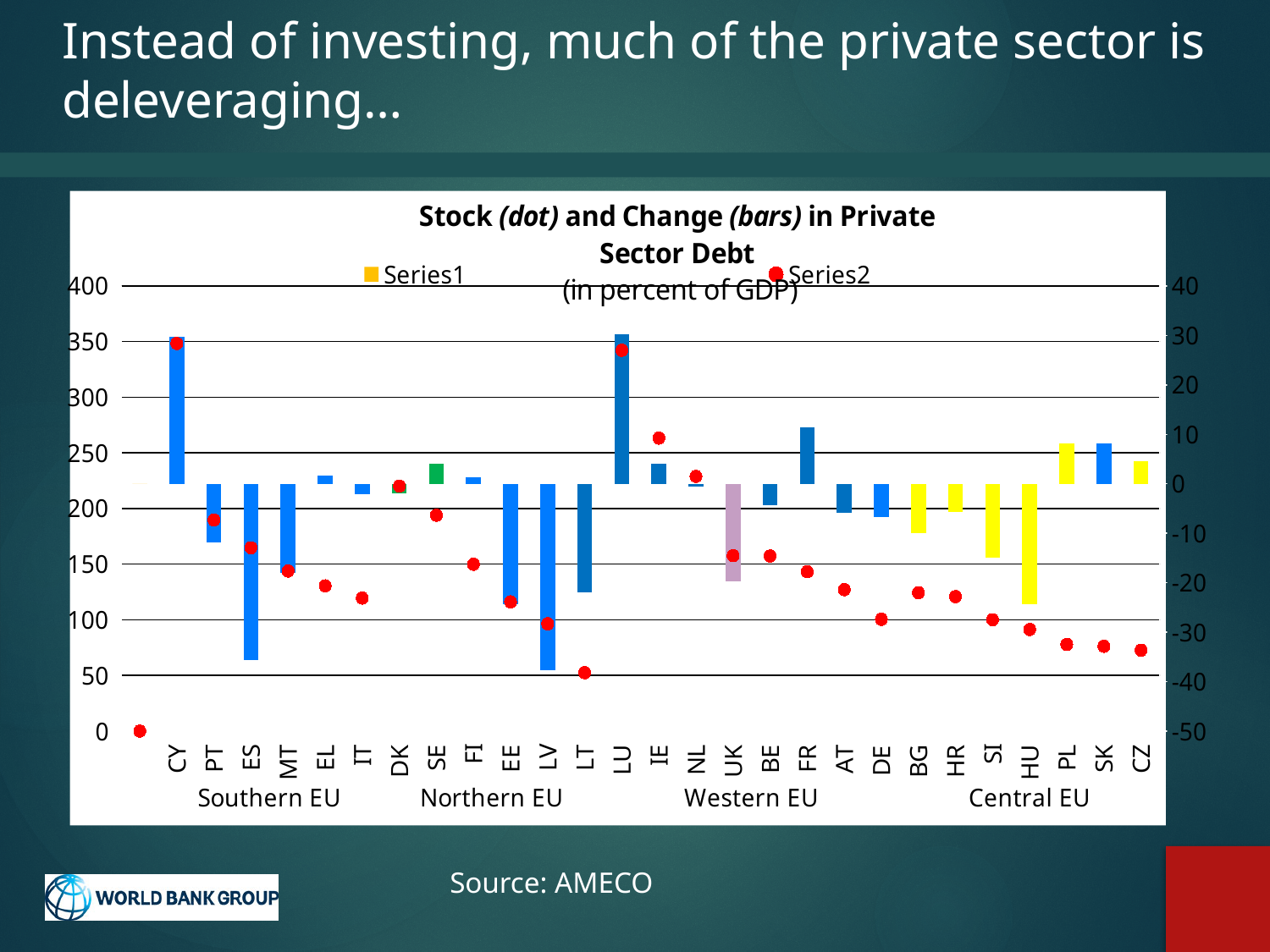
Which has the larger change in private sector debt (bar), FR or UK? FR Is the stock of private sector debt (dot) for CZ greater or less than 100 on the left axis? less Which has the larger stock of private sector debt (dot), CY or PT? CY How many series does the chart legend list? 2 How many country categories are shown on the x axis of the chart? 27 How many regional groups (e.g. Southern EU) are labelled along the x axis? 4 What kind of chart is this? Bar chart combined with dot markers (combo chart) Is the stock of private sector debt (dot) for LT greater or less than 100 on the left axis? less Is the change in private sector debt (bar) for ES greater or less than -20 on the right axis? less What is the title of the chart? Stock (dot) and Change (bars) in Private Sector Debt (in percent of GDP)